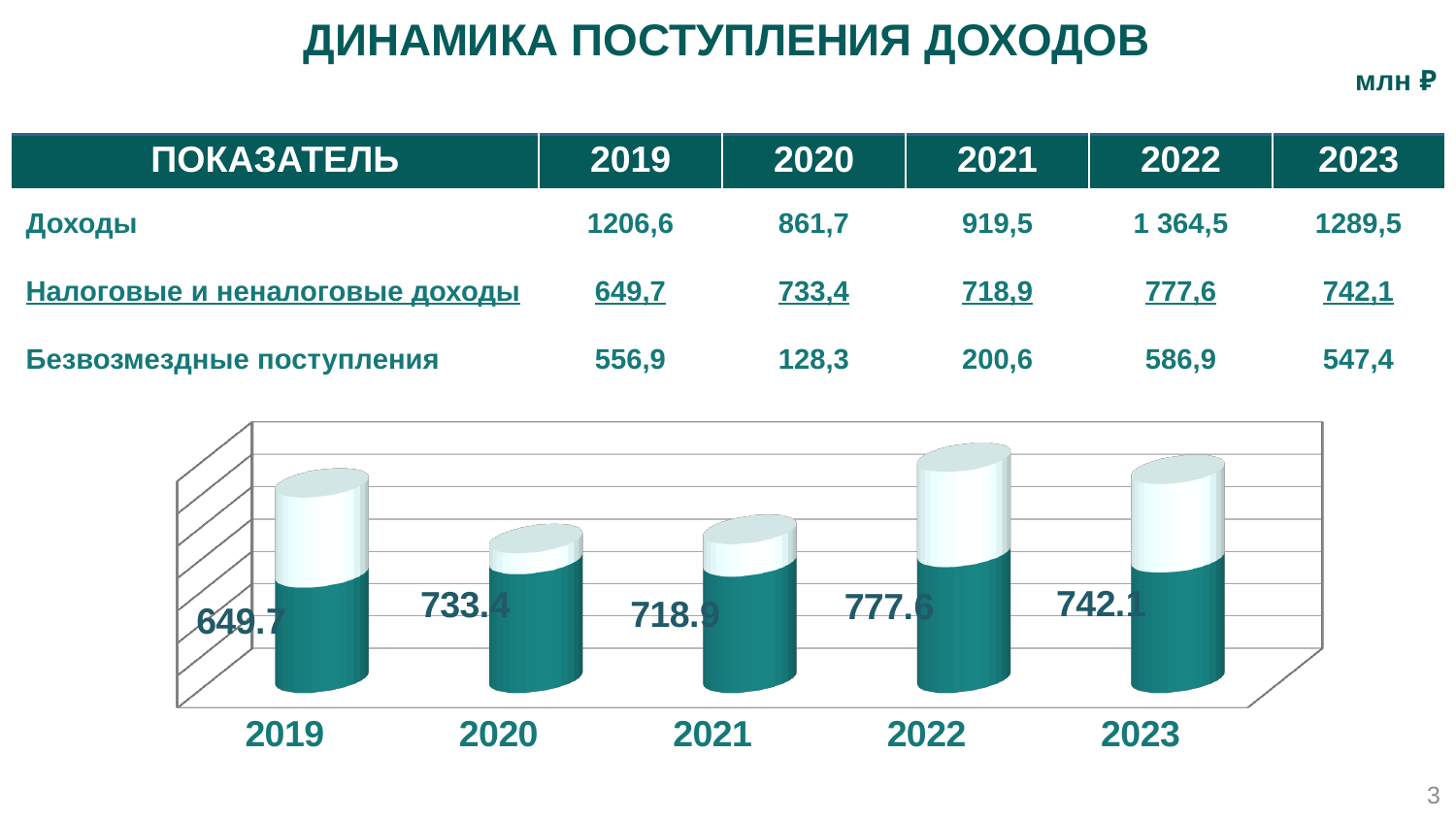
According to the data labels on the chart, which year has the highest value? 2022 What value is labelled on the chart for 2020? 733.4 What value is labelled on the chart for 2021? 718.9 What value is labelled on the chart for 2019? 649.7 According to the data labels on the chart, which year has the lowest value? 2019 What value is labelled on the chart for 2023? 742.1 How many years are shown on the x axis of the chart? 5 What value is labelled on the chart for 2022? 777.6 What kind of chart is shown on the slide? Bar chart Which labelled value on the chart is larger, 2020 or 2021? 2020 What is the difference between the labelled values for 2022 and 2019 on the chart? 127.9 Do the labelled values on the chart rise or fall from 2022 to 2023? Fall